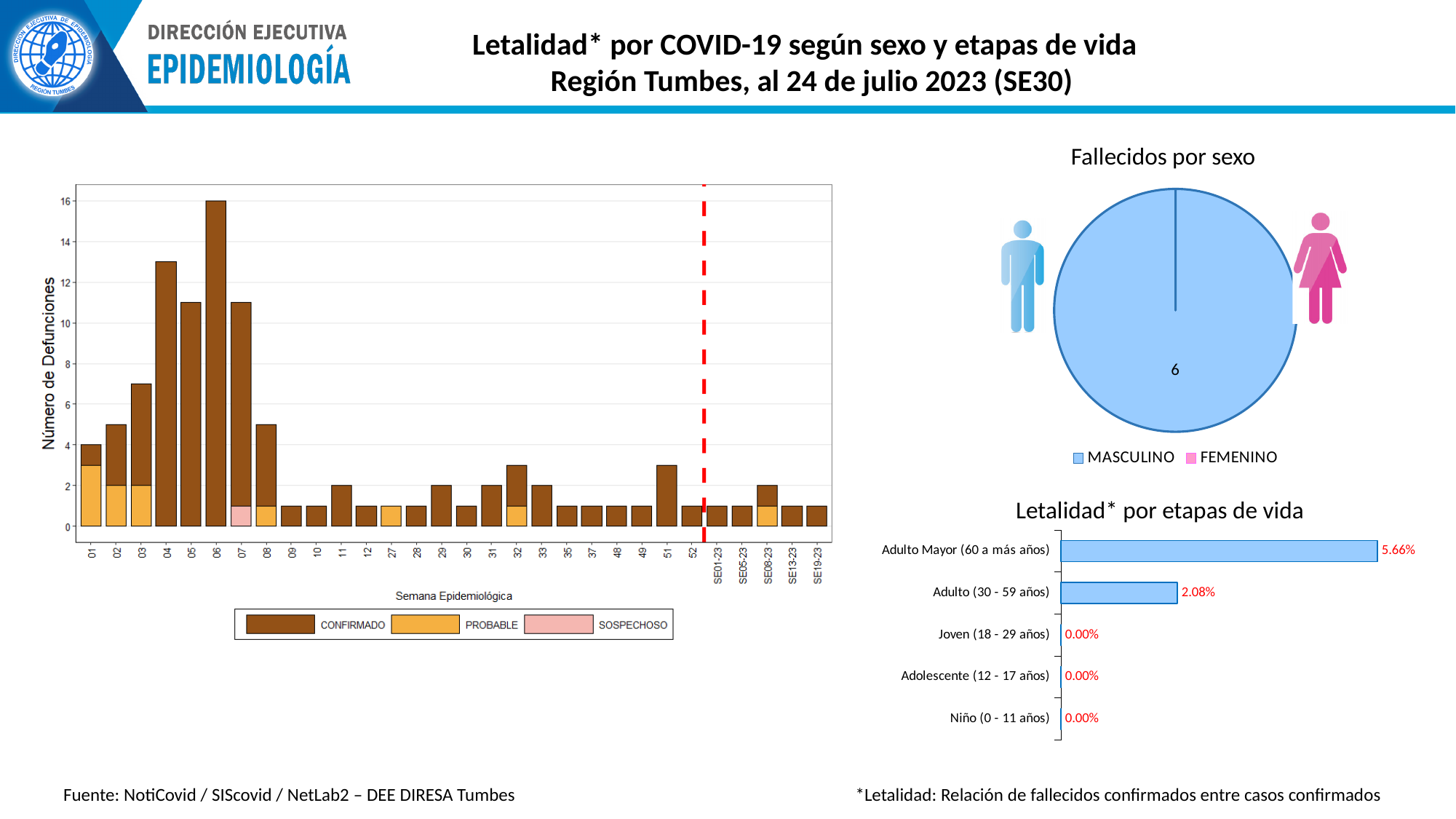
What kind of chart is 'Fallecidos por sexo'? pie chart In the left chart of Número de Defunciones, which epidemiological week has the highest bar? 06 In the 'Letalidad* por etapas de vida' chart, what is the value for Adulto Mayor (60 a más años)? 5.66% In the 'Fallecidos por sexo' chart, how many entries does the legend list? 2 In the 'Fallecidos por sexo' chart, what value is shown for MASCULINO? 6 In the left chart of Número de Defunciones, is the total for week 04 greater or less than 12? greater In the 'Letalidad* por etapas de vida' chart, what is the value for Adulto (30 - 59 años)? 2.08% In the left chart of Número de Defunciones, how many series does the legend list? 3 How many categories are shown in the 'Letalidad* por etapas de vida' chart? 5 In the left chart of Número de Defunciones, is the total for week 05 greater or less than 12? less In the 'Letalidad* por etapas de vida' chart, what is the difference between the values for Adulto Mayor (60 a más años) and Adulto (30 - 59 años)? 3.58% What kind of chart is the chart on the left of the slide showing Número de Defunciones by Semana Epidemiológica? bar chart